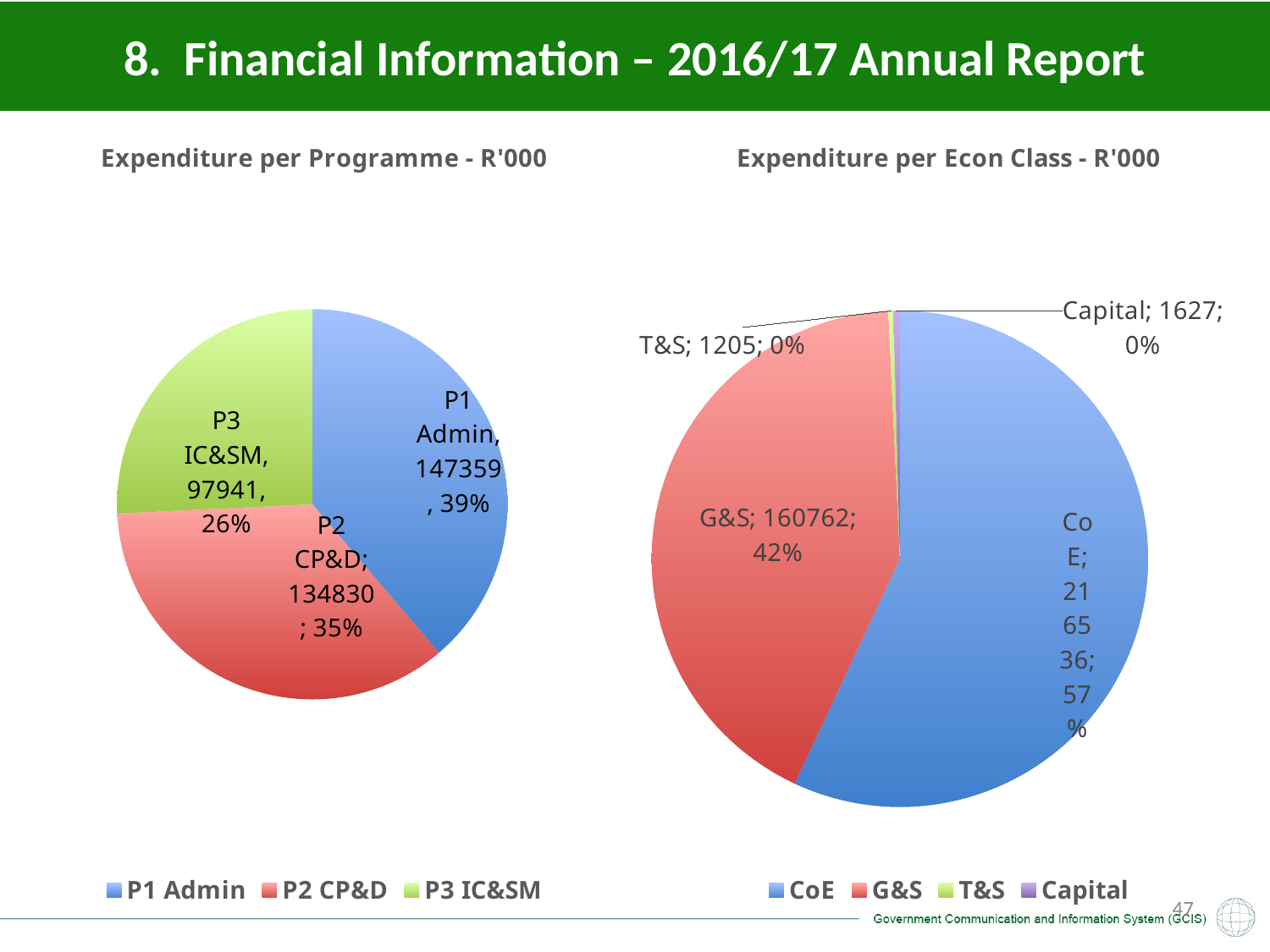
What type of chart is the 'Expenditure per Econ Class - R'000' chart? Pie chart In the 'Expenditure per Programme - R'000' chart, what is the value for P1 Admin? 147359 In the 'Expenditure per Programme - R'000' chart, which programme has the smallest expenditure? P3 IC&SM How many slices does the 'Expenditure per Programme - R'000' chart have? 3 In the 'Expenditure per Econ Class - R'000' chart, which category has the largest share? CoE In the 'Expenditure per Programme - R'000' chart, which programme has the largest expenditure? P1 Admin In the 'Expenditure per Econ Class - R'000' chart, what is the value for Capital? 1627 In the 'Expenditure per Econ Class - R'000' chart, what is the value for G&S? 160762 In the 'Expenditure per Programme - R'000' chart, what share of the pie does P3 IC&SM represent? 26% How many entries does the legend of the 'Expenditure per Econ Class - R'000' chart list? 4 In the 'Expenditure per Programme - R'000' chart, what is the difference between the values for P1 Admin and P2 CP&D? 12529 In the 'Expenditure per Econ Class - R'000' chart, which is larger, T&S or Capital? Capital